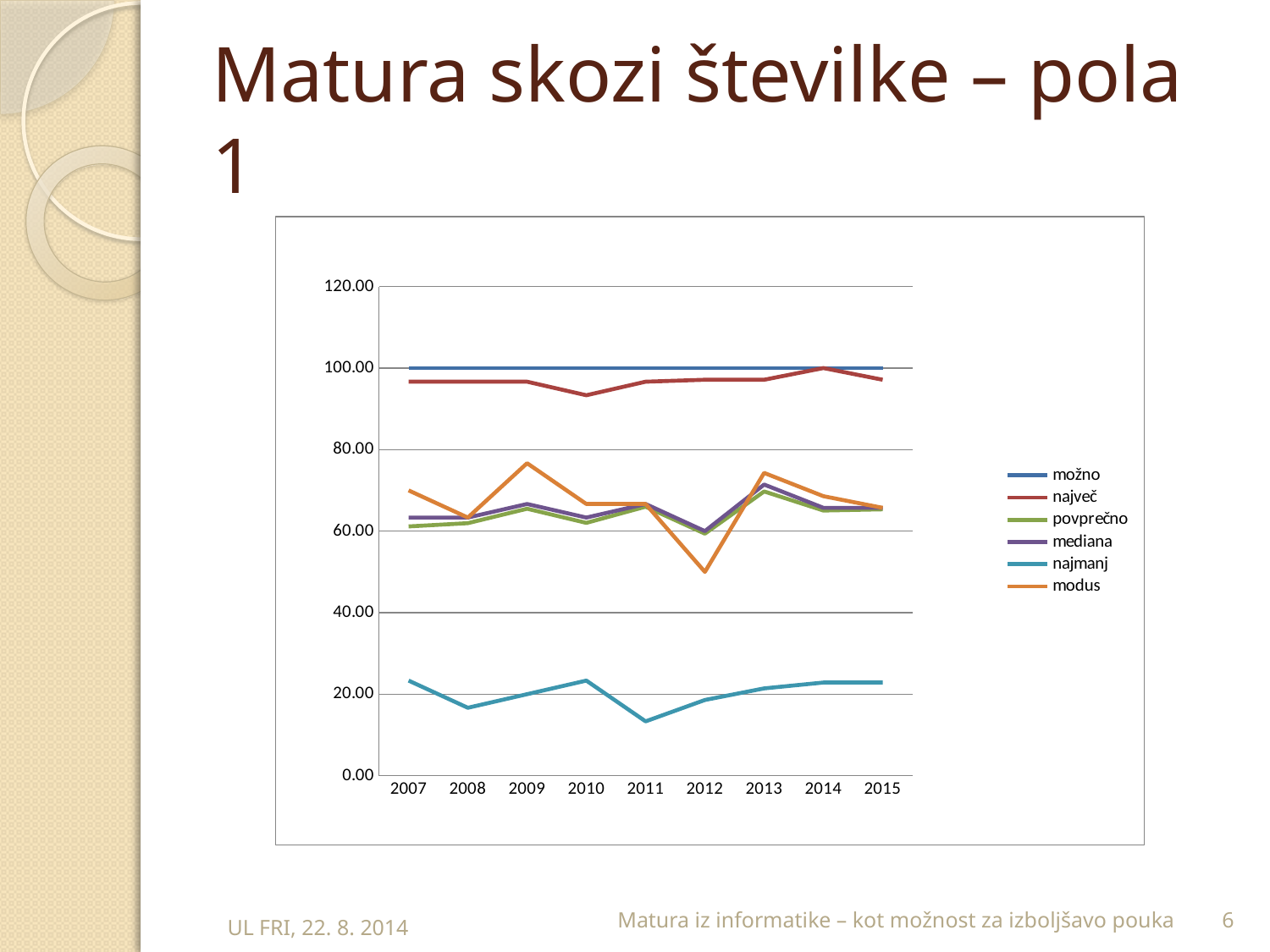
Is the value for 'največ' in 2010 greater or less than 100.00? less How many years are shown on the x axis? 9 How many series does the legend list? 6 What kind of chart is shown on the slide? line chart Is the value for 'modus' in 2012 greater or less than 60.00? less In which year is the 'najmanj' series at its lowest? 2011 Does the 'najmanj' series rise or fall from 2011 to 2015? rise Is the value for 'najmanj' in 2011 greater or less than 20.00? less In which year is the 'modus' series at its lowest? 2012 What is the value of the 'možno' series in 2007? 100.00 In 2012, which is larger: 'mediana' or 'modus'? mediana